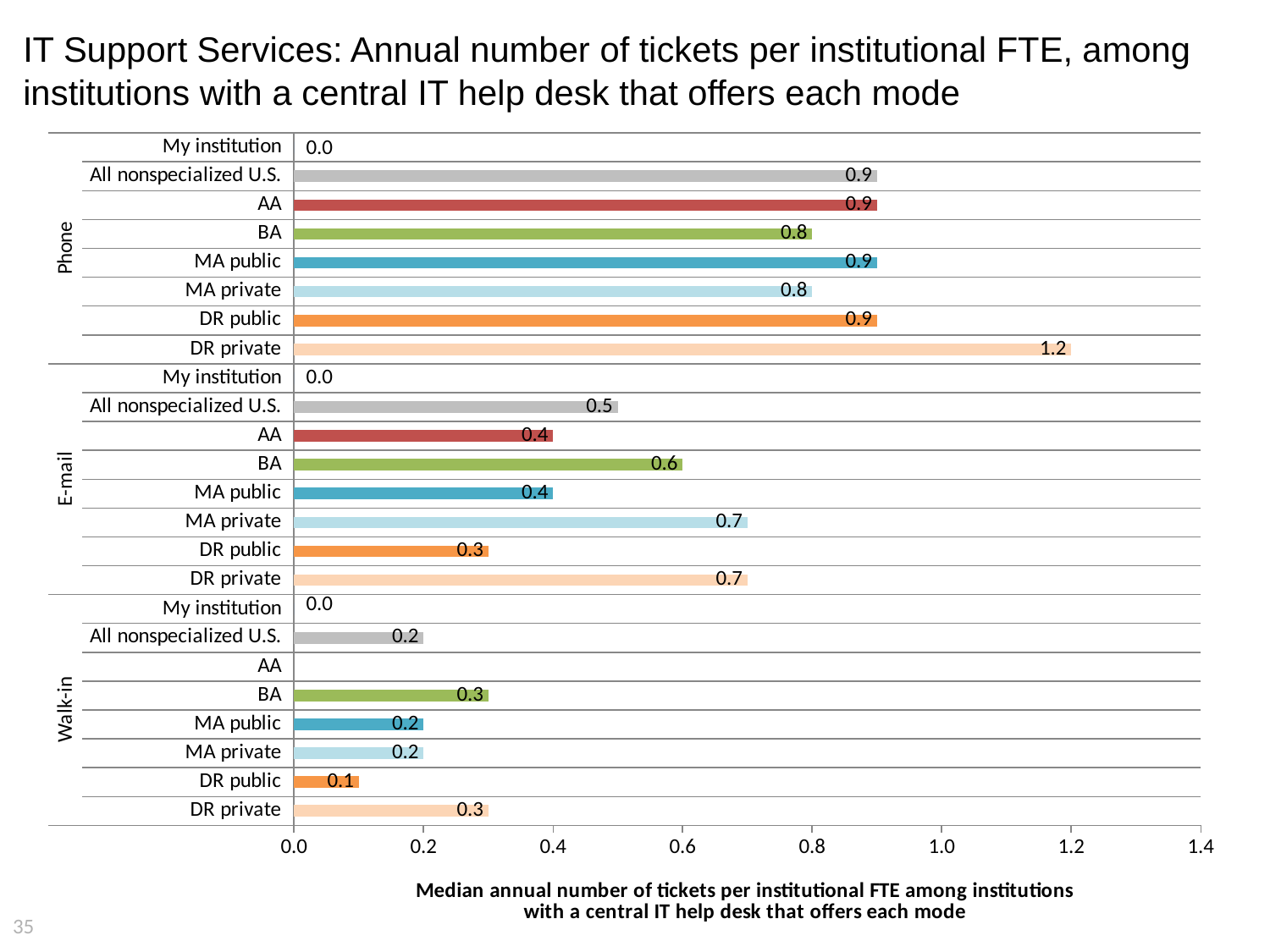
How many mode groups (Phone, E-mail, Walk-in) are shown on the chart? 3 In the E-mail group, which is larger: the value for BA or the value for AA? BA What is the value for DR public in the Walk-in group? 0.1 Excluding My institution, which category in the Walk-in group has the lowest value? DR public What is the value for MA private in the E-mail group? 0.7 What is the value for DR private in the Phone group? 1.2 What is the difference between the DR private and BA values in the Phone group? 0.4 What is the value for All nonspecialized U.S. in the E-mail group? 0.5 What is the x-axis title of the chart? Median annual number of tickets per institutional FTE among institutions with a central IT help desk that offers each mode What kind of chart is shown on the slide? bar chart Is the value for DR private in the Phone group greater or less than 1.0? greater Which category in the Phone group has the highest value? DR private